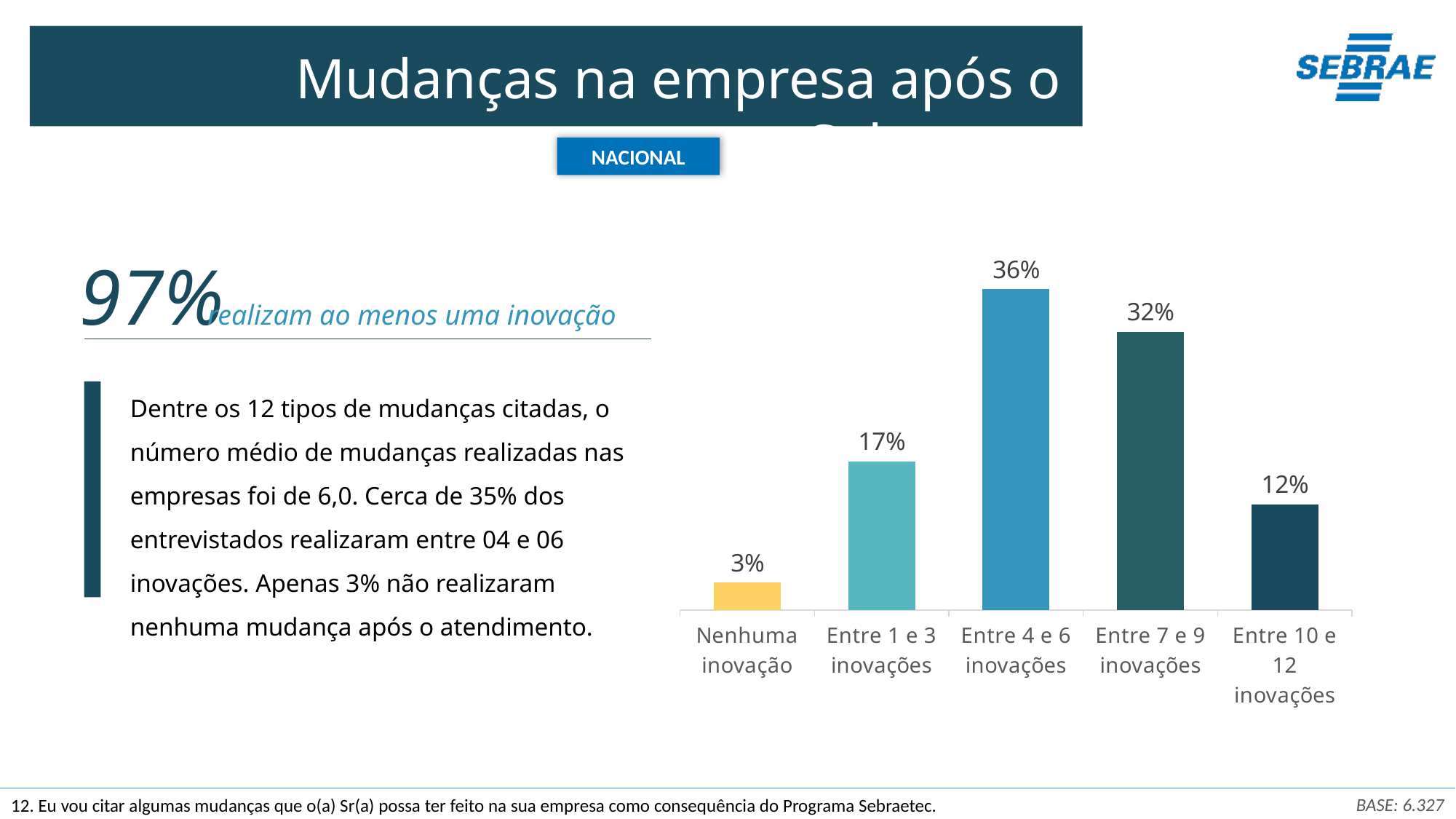
What is the value for 'Nenhuma inovação'? 3% Which category has the lowest value? Nenhuma inovação How many categories are shown in the chart? 5 What is the difference between 'Entre 4 e 6 inovações' and 'Entre 7 e 9 inovações'? 4% What is the value for 'Entre 10 e 12 inovações'? 12% What is the value for 'Entre 4 e 6 inovações'? 36% What is the value for 'Entre 1 e 3 inovações'? 17% Which category has the highest value? Entre 4 e 6 inovações What is the difference between 'Entre 1 e 3 inovações' and 'Entre 10 e 12 inovações'? 5% What kind of chart is shown on the slide? Bar chart Which is larger: 'Entre 7 e 9 inovações' or 'Entre 1 e 3 inovações'? Entre 7 e 9 inovações What colour is the bar for 'Nenhuma inovação'? Yellow